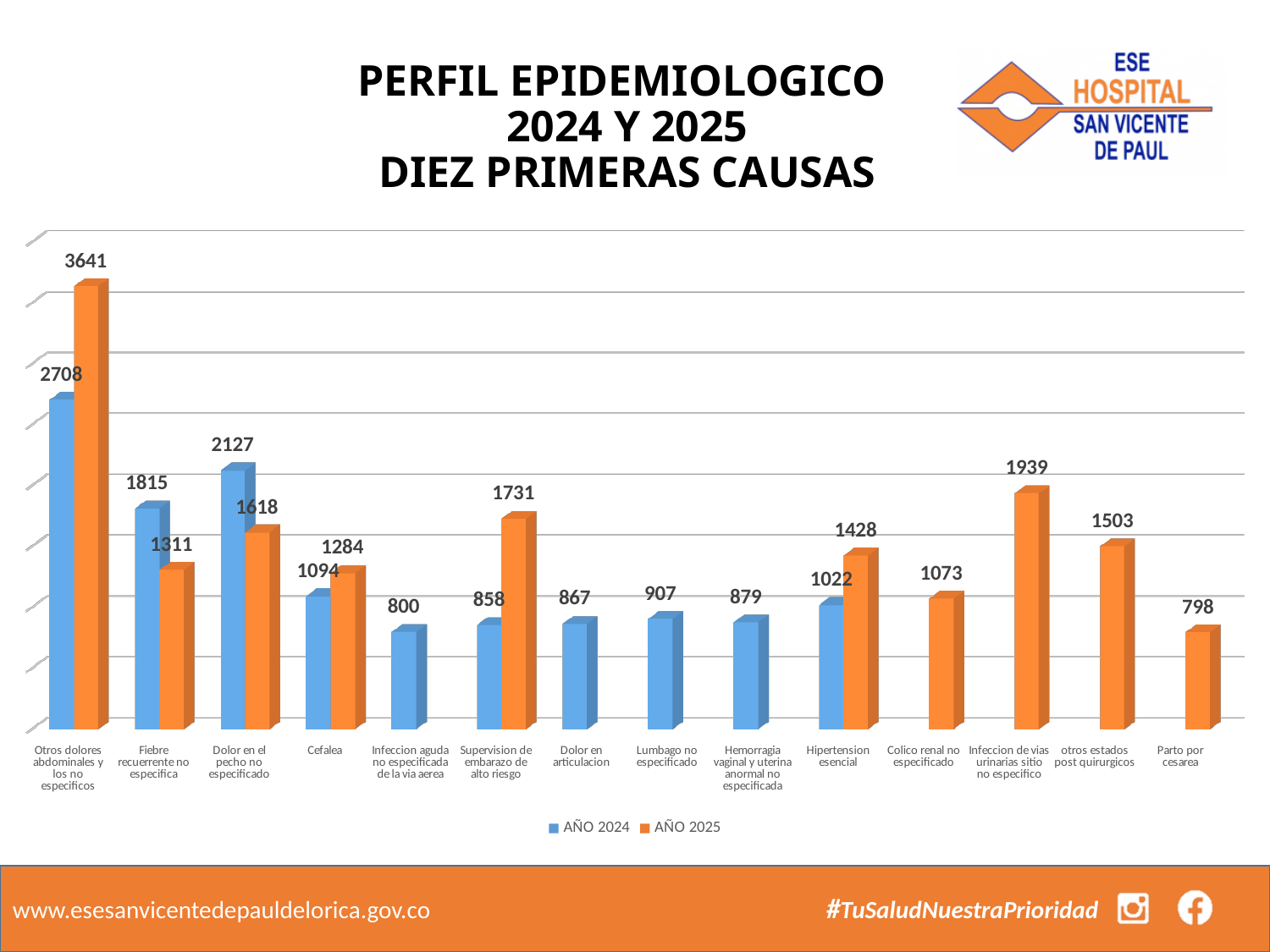
What is the value for AÑO 2024 for Dolor en el pecho no especificado? 2127 Which category has the lowest AÑO 2025 value? Parto por cesarea Which category has the highest AÑO 2025 value? Otros dolores abdominales y los no especificos What is the difference between the AÑO 2025 and AÑO 2024 values for Hipertension esencial? 406 How many series does the legend list? 2 What is the value for AÑO 2025 for Otros dolores abdominales y los no especificos? 3641 What kind of chart is shown on the slide? Bar chart What is the value for AÑO 2025 for Supervision de embarazo de alto riesgo? 1731 How many categories are shown on the x axis? 14 For Fiebre recuerrente no especifica, which is larger: the AÑO 2024 value or the AÑO 2025 value? AÑO 2024 Which category has the lowest AÑO 2024 value? Infeccion aguda no especificada de la via aerea What is the value for AÑO 2024 for Lumbago no especificado? 907